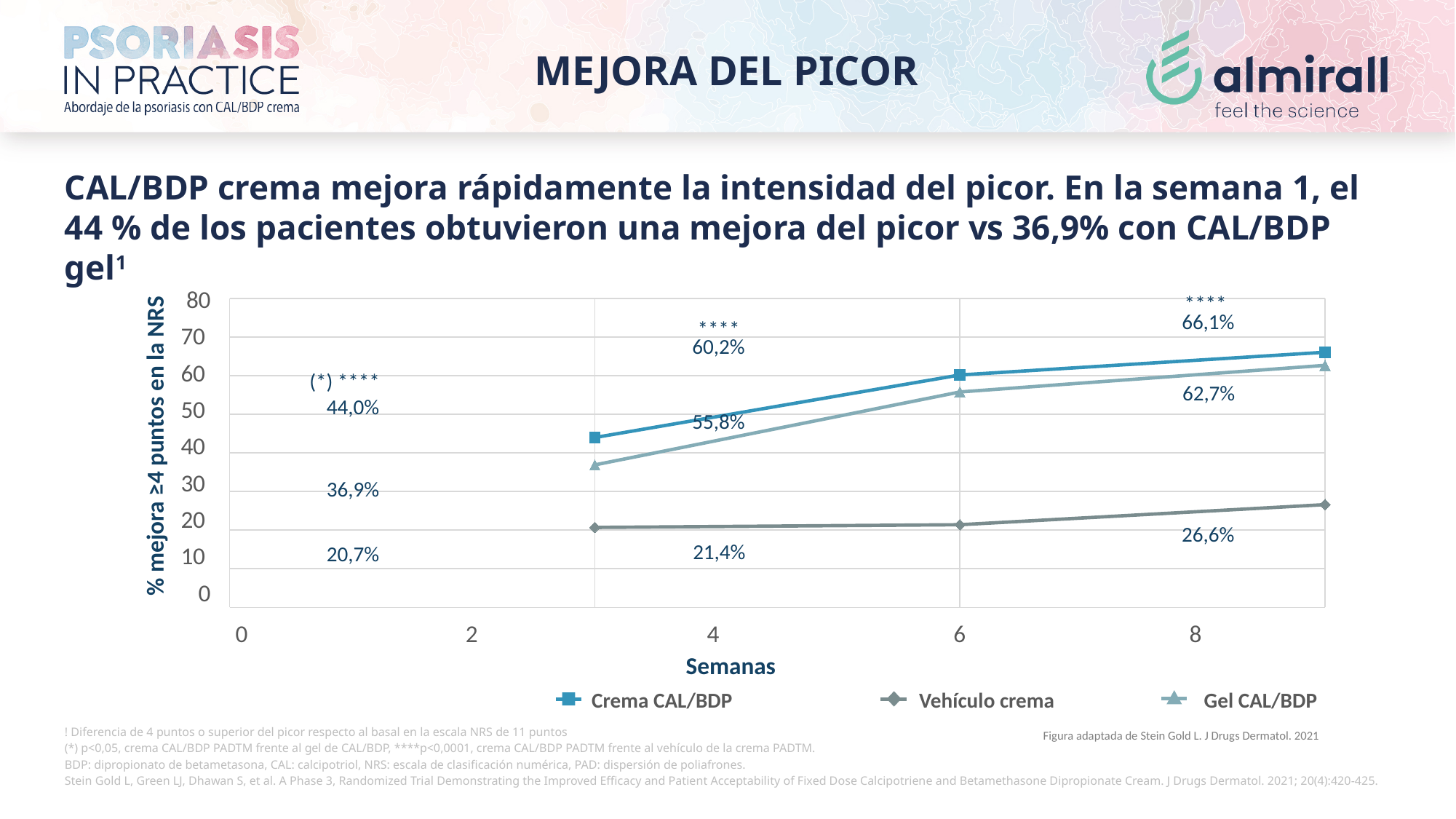
How many series does the chart legend list? 3 Do the values for the Crema CAL/BDP series rise or fall along the x axis? rise What is the highest labelled value for the Crema CAL/BDP series? 66,1% What is the middle labelled value for the Vehículo crema series? 21,4% What kind of chart is shown on the slide? line chart How many data points are plotted for the Crema CAL/BDP series? 3 Which series has the higher final value, Crema CAL/BDP or Vehículo crema? Crema CAL/BDP What is the difference between the final labelled values of Crema CAL/BDP (66,1%) and Gel CAL/BDP (62,7%)? 3,4 percentage points What is the difference between the first labelled values of Crema CAL/BDP (44,0%) and Gel CAL/BDP (36,9%)? 7,1 percentage points What is the final labelled value for the Gel CAL/BDP series? 62,7% What is the label of the x axis of the chart? Semanas What is the lowest labelled value for the Vehículo crema series? 20,7%